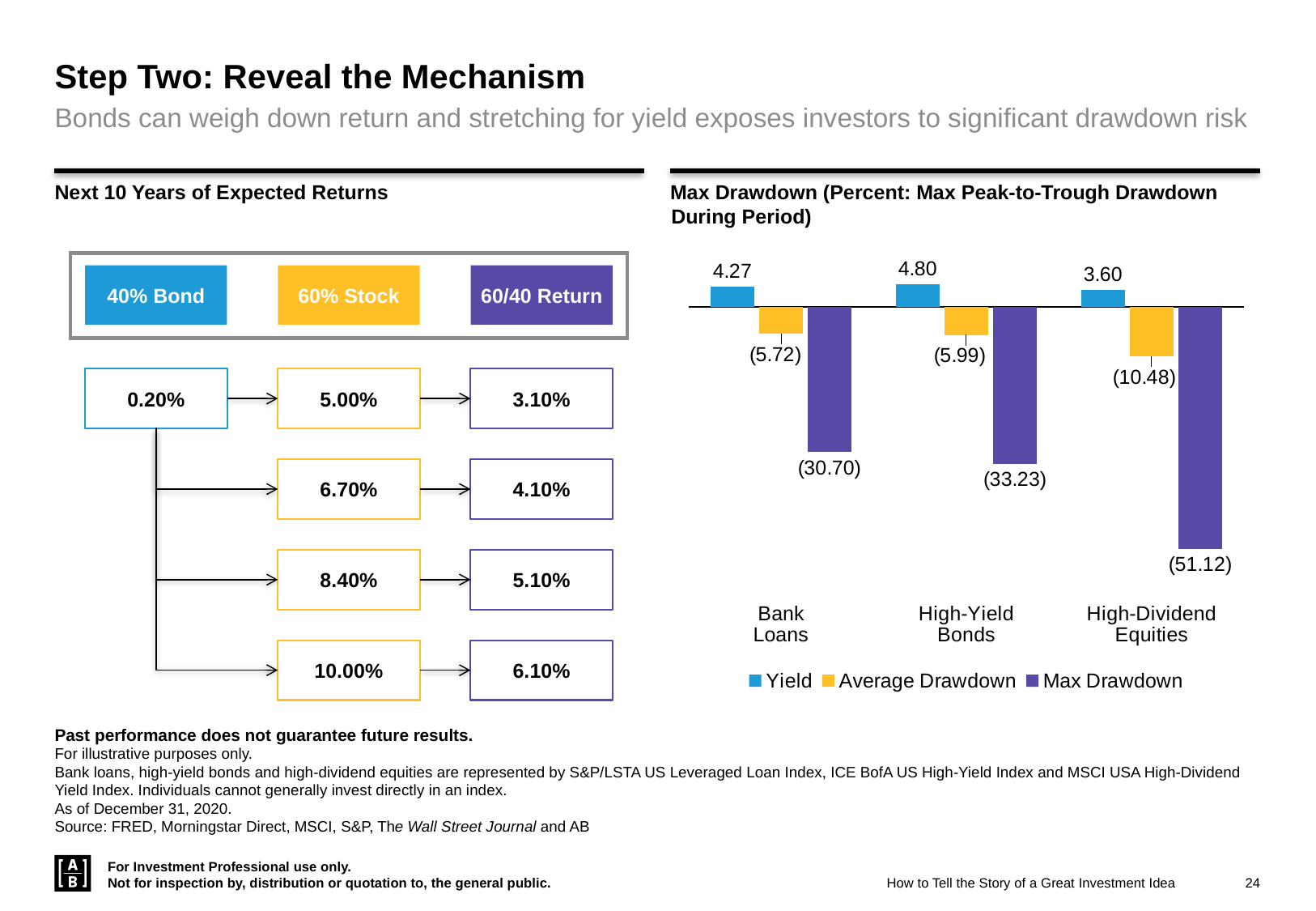
In the Max Drawdown chart, which category has the lowest Yield? High-Dividend Equities In the Max Drawdown chart, which has the larger Max Drawdown, Bank Loans or High-Yield Bonds? High-Yield Bonds In the Max Drawdown chart, what is the Max Drawdown value for High-Dividend Equities? (51.12) In the Max Drawdown chart, which category has the highest Yield? High-Yield Bonds What kind of chart is the Max Drawdown chart? Bar chart How many categories are shown on the x axis of the Max Drawdown chart? 3 In the Max Drawdown chart, what is the difference between the Yield for High-Yield Bonds and the Yield for Bank Loans? 0.53 In the Max Drawdown chart, what is the Average Drawdown value for High-Yield Bonds? (5.99) How many series does the legend of the Max Drawdown chart list? 3 In the Max Drawdown chart, what is the difference between the Average Drawdown for High-Dividend Equities and the Average Drawdown for Bank Loans? 4.76 What are the legend entries of the Max Drawdown chart? Yield, Average Drawdown, Max Drawdown In the Max Drawdown chart, what is the Yield value for Bank Loans? 4.27